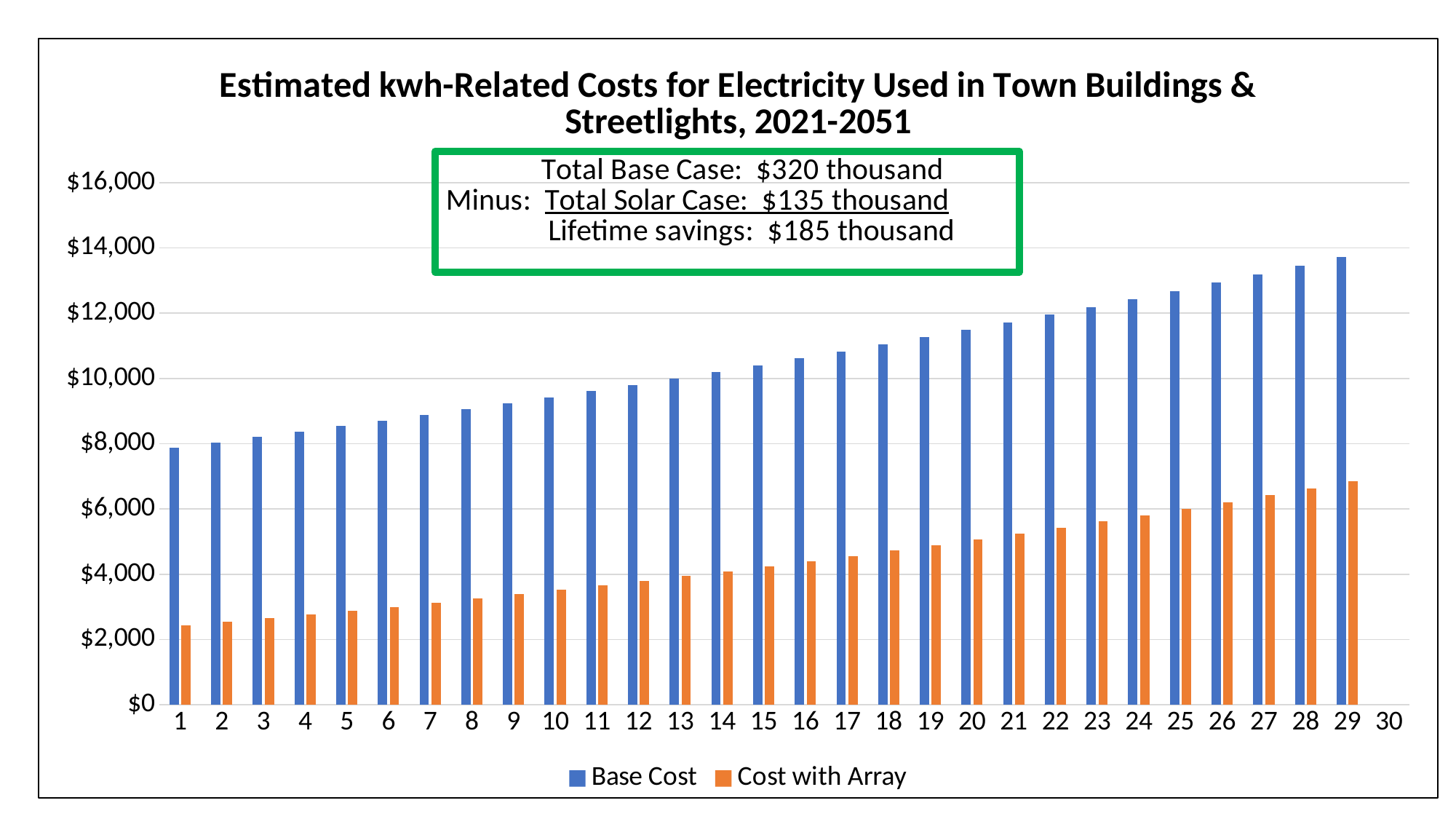
Which year has the lowest Cost with Array? 1 Is the Cost with Array value for year 1 greater or less than $4,000? less Is the Base Cost value for year 29 greater or less than $12,000? greater Is the Cost with Array value for year 20 greater or less than $4,000? greater Which year has the highest Base Cost? 29 Which series does the orange bar represent? Cost with Array In year 10, which is larger: Base Cost or Cost with Array? Base Cost Do the Base Cost values rise or fall from year 1 to year 29? rise How many series does the legend list? 2 What kind of chart is shown on the slide? bar chart